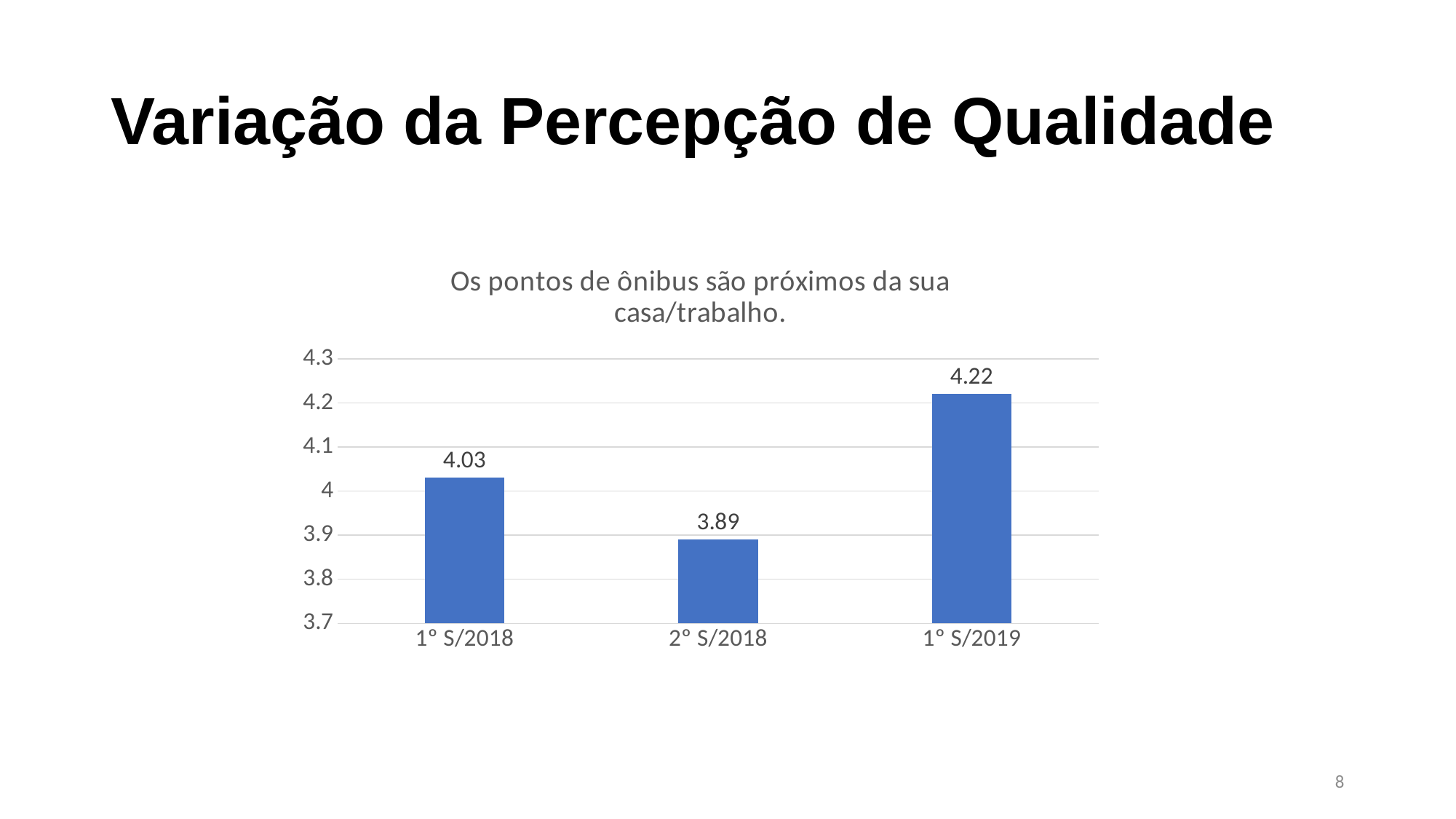
Which period has the highest value? 1° S/2019 Is the value for 2° S/2018 greater or less than 4? less What is the value for 1° S/2019? 4.22 What is the difference between the values for 1° S/2019 and 2° S/2018? 0.33 How many periods are shown on the x axis? 3 What is the title of the chart? Os pontos de ônibus são próximos da sua casa/trabalho. What is the value for 2° S/2018? 3.89 Which is larger, the value for 1° S/2018 or the value for 1° S/2019? 1° S/2019 Which period has the lowest value? 2° S/2018 What kind of chart is shown on the slide? bar chart What is the difference between the values for 1° S/2018 and 2° S/2018? 0.14 What is the value for 1° S/2018? 4.03